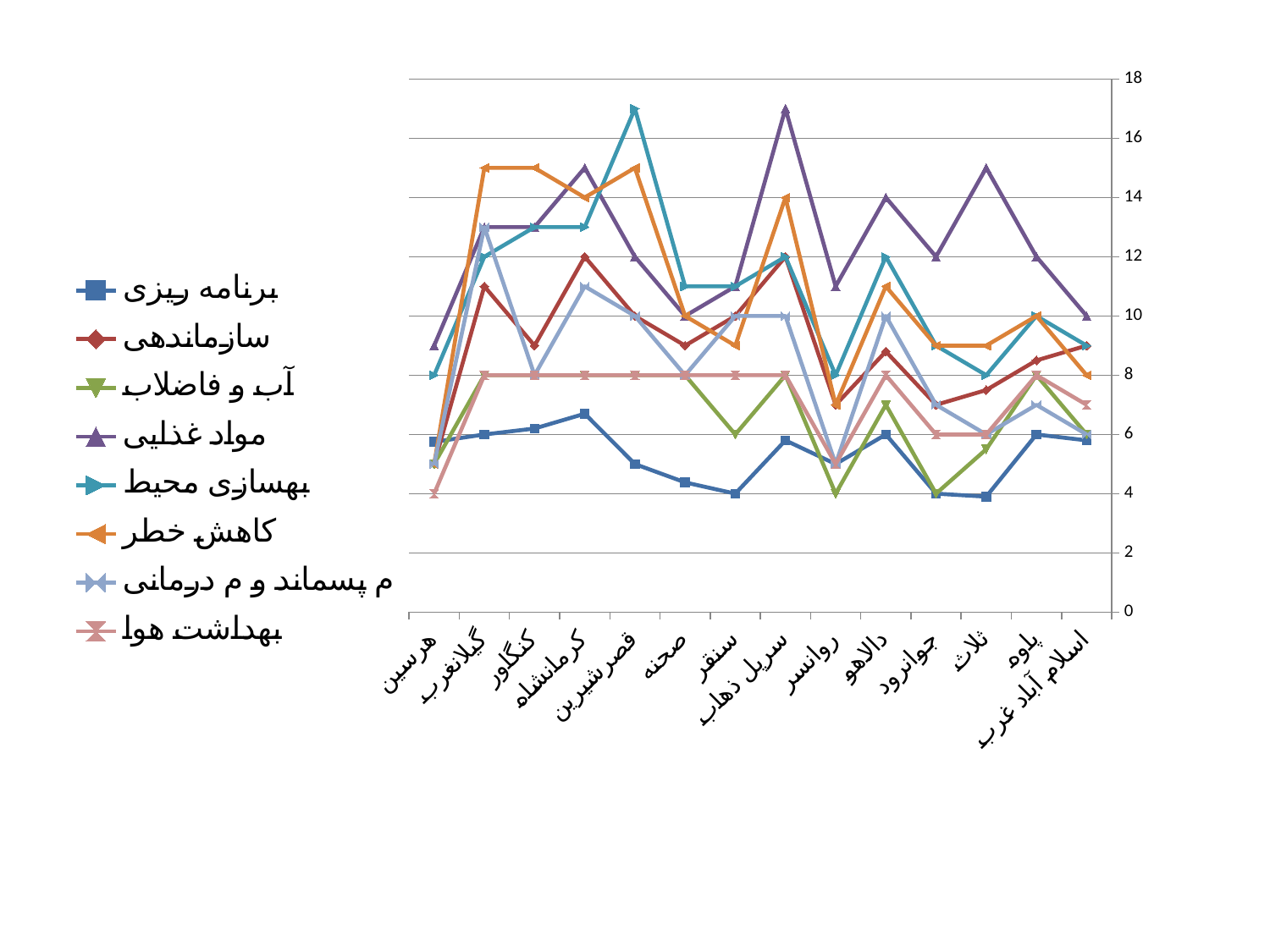
How many categories are shown along the x axis? 14 Which series has the lowest value at هرسین? بهداشت هوا What type of chart is shown on the slide? line chart What value does مواد غذایی have at دالاهو? 14 Does the مواد غذایی series rise or fall from ثلاث to اسلام آباد غرب? fall At کنگاور, which is larger: کاهش خطر or سازماندهی? کاهش خطر Is the value for برنامه ریزی at کرمانشاه greater or less than 8? less How many series does the legend list? 8 Which series has the highest value at سرپل ذهاب? مواد غذایی Is the value for بهسازی محیط at قصرشیرین greater or less than 16? greater Is the value for مواد غذایی at سرپل ذهاب greater or less than 16? greater What value does بهداشت هوا have at گیلانغرب? 8